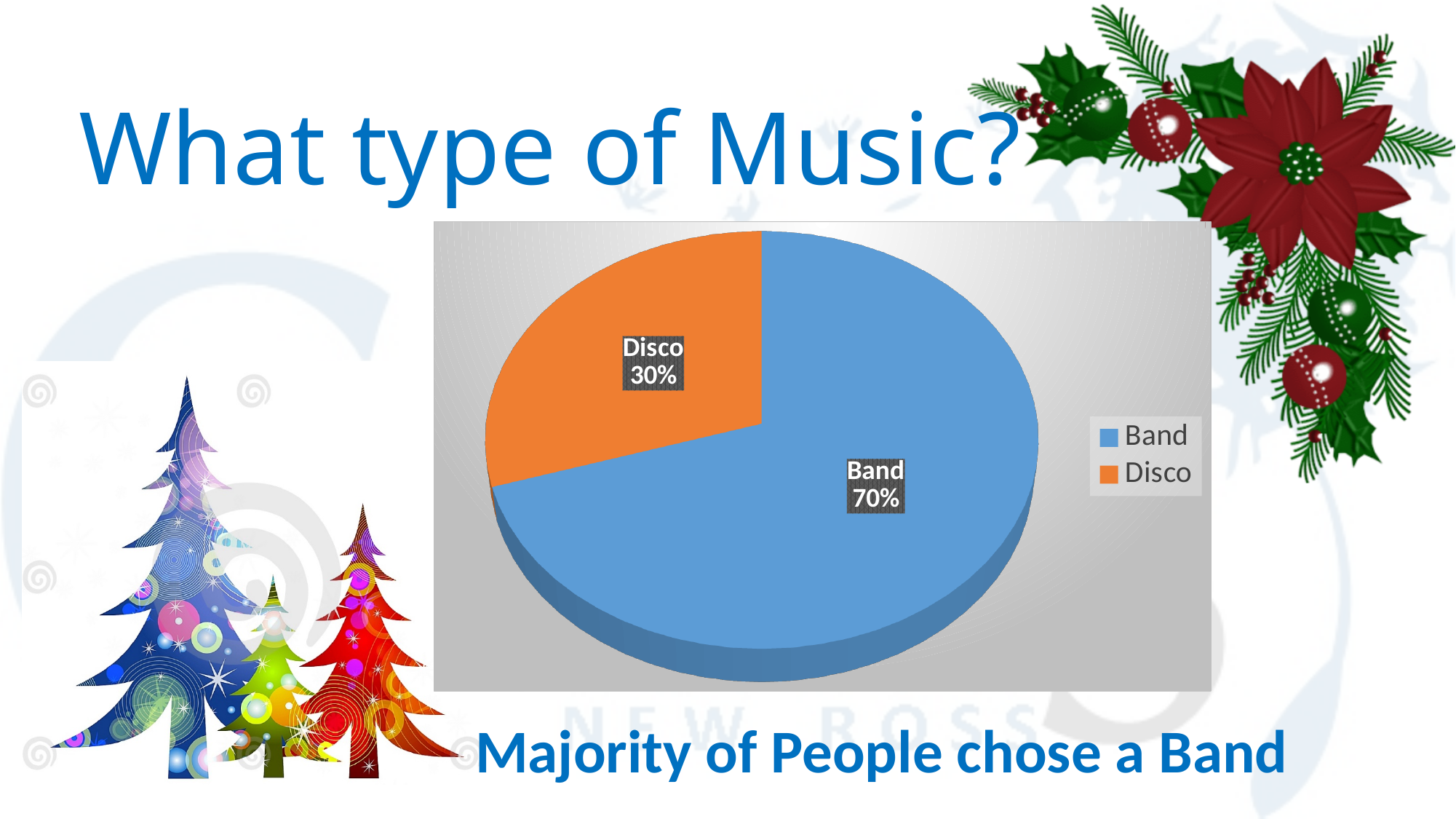
How many slices does the pie chart have? 2 Which is larger, the Band slice or the Disco slice? Band What colour is the Band slice? blue What kind of chart is shown on the slide? pie chart What is the difference in percentage points between Band and Disco? 40 How many entries does the legend list? 2 Which category has the largest slice of the pie? Band What share of the pie does Band have? 70% What colour is the Disco slice? orange Which category has the smallest slice of the pie? Disco What share of the pie does Disco have? 30%